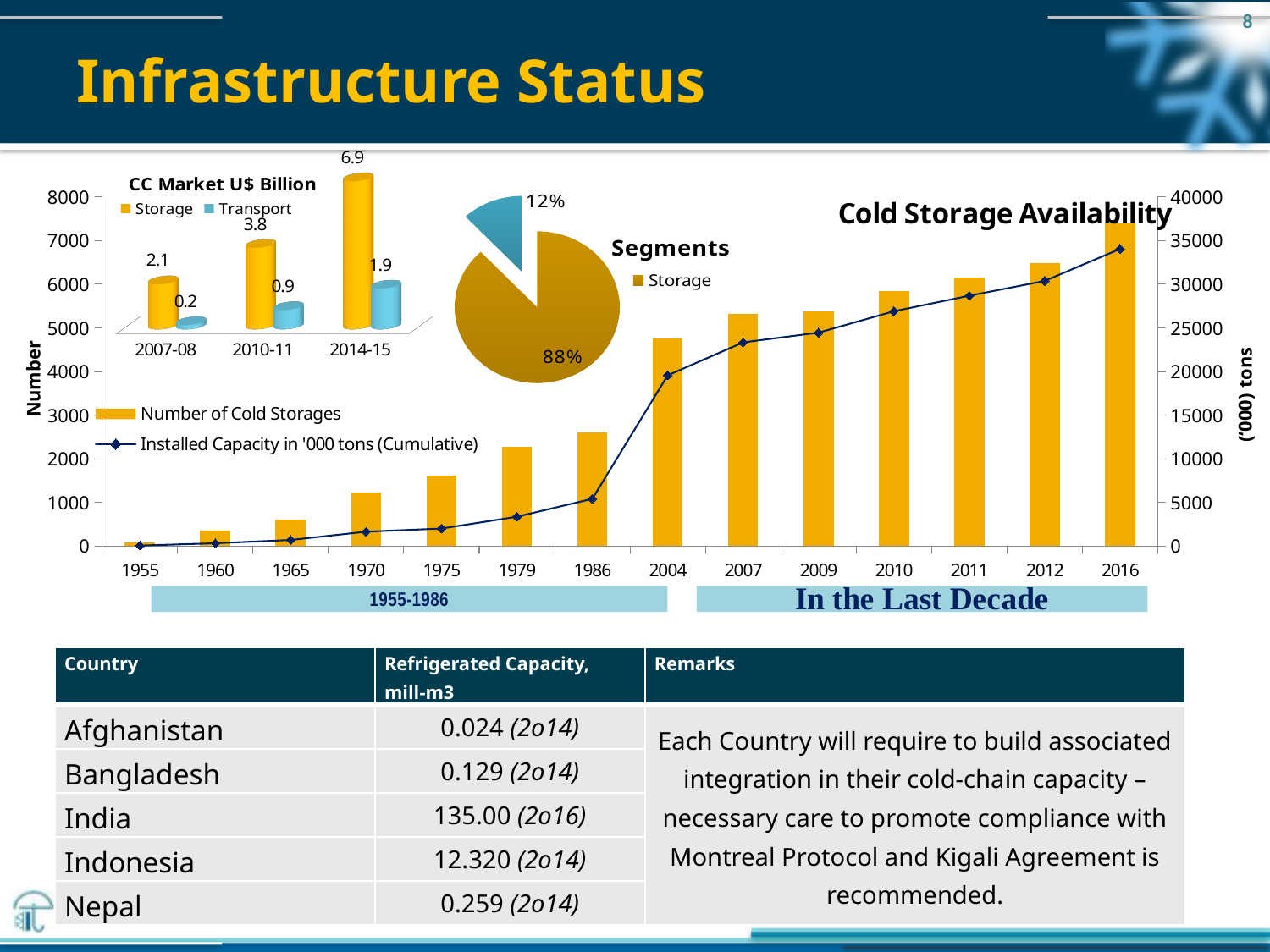
In the CC Market U$ Billion chart, how many series does the legend list? 2 In the CC Market U$ Billion chart, what is the Storage value for 2014-15? 6.9 What kind of chart is the Cold Storage Availability chart? Combined bar and line chart In the Cold Storage Availability chart, is the Number of Cold Storages in 2004 greater or less than 5000? less In the Cold Storage Availability chart, does the Installed Capacity line rise or fall from 1955 to 2016? rise In the CC Market U$ Billion chart, which period has the highest Storage value? 2014-15 In the CC Market U$ Billion chart, what is the difference between Storage and Transport in 2010-11? 2.9 In the Cold Storage Availability chart, how many years are shown on the x axis? 14 In the Cold Storage Availability chart, which year has the highest Number of Cold Storages? 2016 In the Segments pie chart, how many slices are there? 2 In the Segments pie chart, what share does the larger slice have? 88% In the CC Market U$ Billion chart, what is the Transport value for 2007-08? 0.2